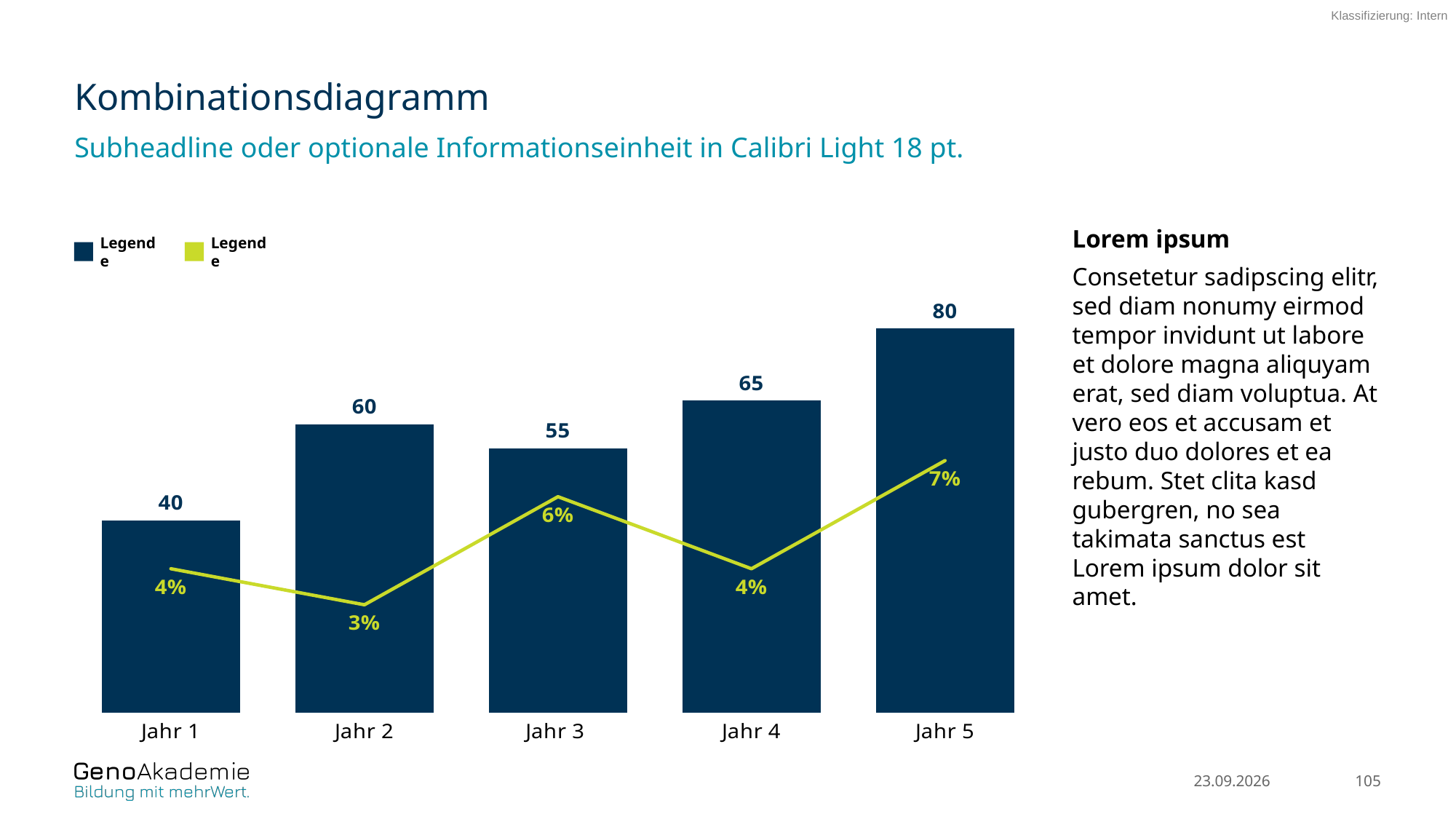
What colour is the line series? Yellow-green Which has the larger bar value, Jahr 2 or Jahr 3? Jahr 2 Which year has the lowest line value? Jahr 2 What kind of chart is shown on the slide? Combination bar and line chart Which year has the highest bar value? Jahr 5 How many series does the legend list? 2 How many years are shown on the x axis? 5 What is the bar value for Jahr 3? 55 Which year has the lowest bar value? Jahr 1 What is the difference between the bar values for Jahr 5 and Jahr 1? 40 What is the line value for Jahr 2? 3% What is the line value for Jahr 5? 7%